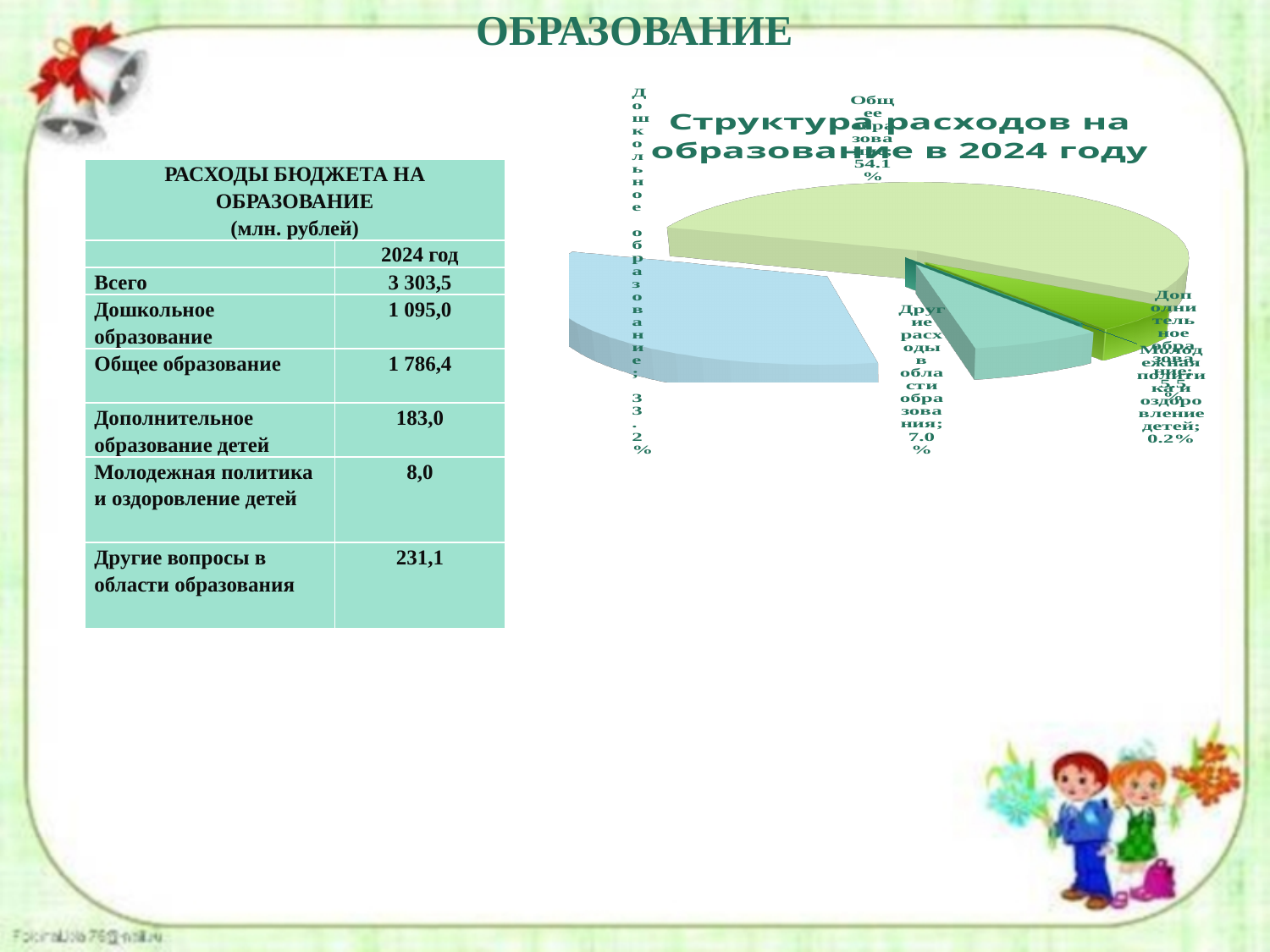
How many slices does the pie chart have? 5 What kind of chart is shown on the slide? pie chart By how many percentage points does the share of Общее образование exceed that of Дошкольное образование? 20.9 What share of the pie chart is Молодежная политика и оздоровление детей? 0.2% Which is larger in the pie chart: Дошкольное образование or Другие расходы в области образования? Дошкольное образование What share of the pie chart is Дошкольное образование? 33.2% What share of the pie chart is Общее образование? 54.1% Is the share of Общее образование in the pie chart greater or less than 50%? greater Which category has the largest share in the pie chart? Общее образование What is the title of the pie chart? Структура расходов на образование в 2024 году Which category has the smallest share in the pie chart? Молодежная политика и оздоровление детей